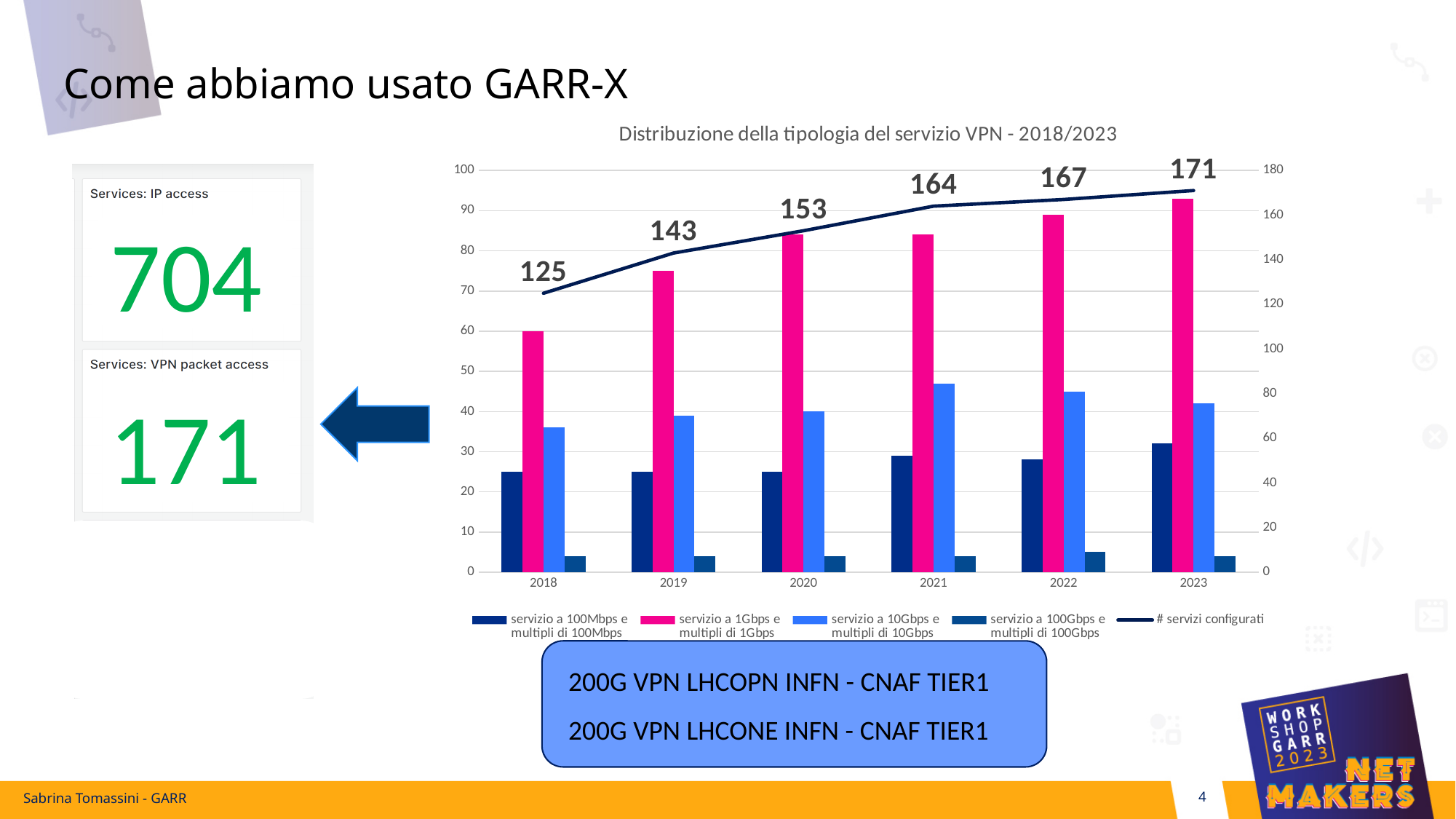
In 2023, which is larger: the bar for 'servizio a 1Gbps e multipli di 1Gbps' or the bar for 'servizio a 10Gbps e multipli di 10Gbps'? servizio a 1Gbps e multipli di 1Gbps What is the difference between '# servizi configurati' in 2023 and in 2018? 46 What is the value of '# servizi configurati' for 2018? 125 How many series does the chart legend list? 5 What is the title of the chart? Distribuzione della tipologia del servizio VPN - 2018/2023 In which year is '# servizi configurati' lowest? 2018 What is the value of '# servizi configurati' for 2023? 171 How many years are shown on the x axis of the chart? 6 Is the value for 'servizio a 1Gbps e multipli di 1Gbps' in 2018 greater or less than 50 on the left axis? greater In which year is '# servizi configurati' highest? 2023 What is the value of '# servizi configurati' for 2021? 164 Does '# servizi configurati' rise or fall from 2018 to 2023? rise